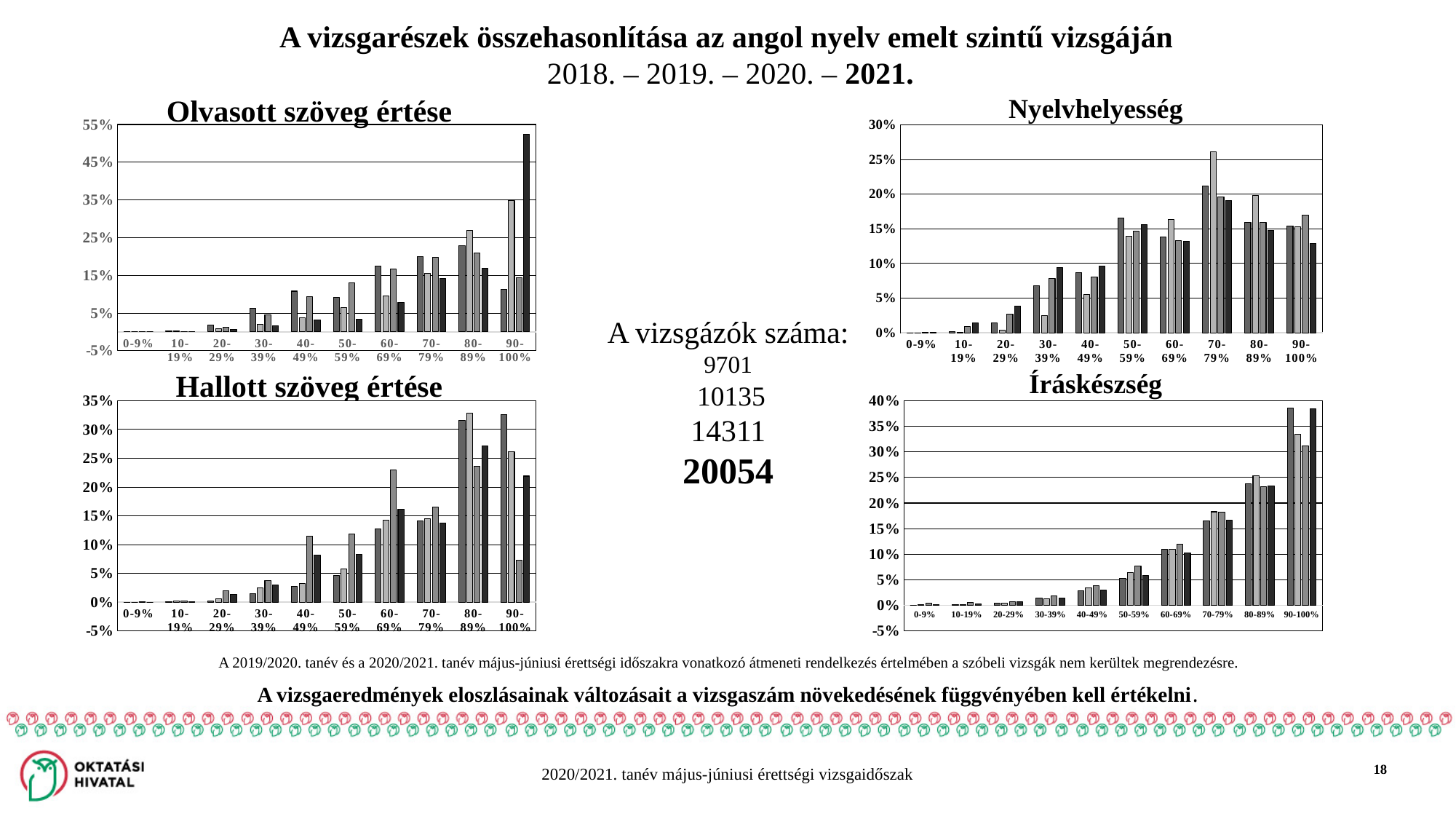
What kind of chart is the 'Olvasott szöveg értése' chart? bar chart How many charts are shown on the slide? 4 In the 'Nyelvhelyesség' chart, are the bars for the 0-9% band greater or less than 5%? less How many score-band categories are shown on the x axis of the 'Íráskészség' chart? 10 In the 'Nyelvhelyesség' chart, which score band has the tallest bar? 70-79% In the 'Olvasott szöveg értése' chart, is the tallest bar for the 90-100% band greater or less than 45%? greater In the 'Hallott szöveg értése' chart, which score band has taller bars: 50-59% or 80-89%? 80-89% In the 'Olvasott szöveg értése' chart, which score band has the tallest bar? 90-100% In the 'Íráskészség' chart, is the tallest bar for the 90-100% band greater or less than 35%? greater In the 'Íráskészség' chart, do the values generally rise or fall from the 0-9% band to the 90-100% band? rise